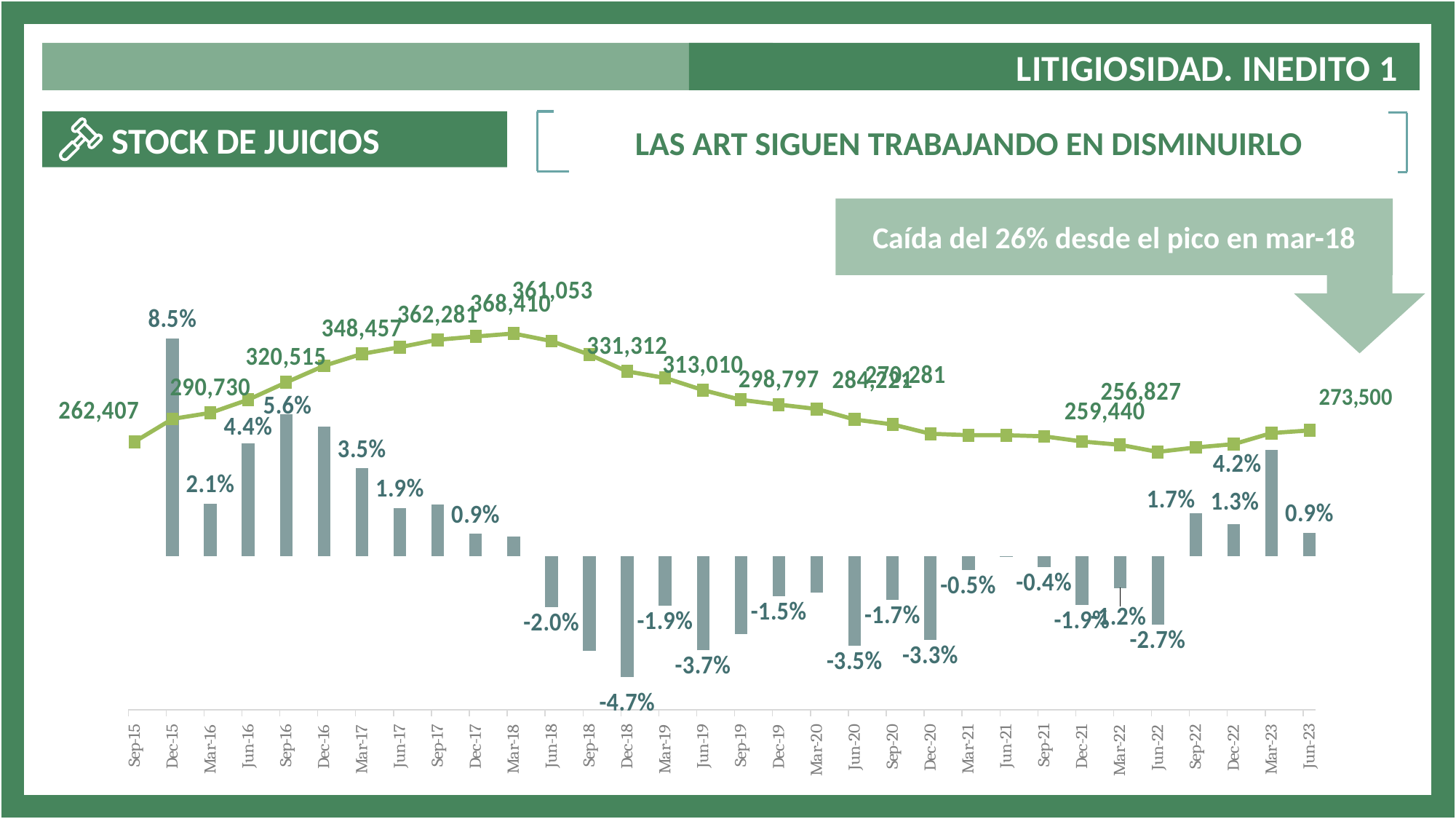
How many quarterly periods are shown on the x axis? 32 What is the percentage change shown by the bar at Dec-15? 8.5% What is the difference between the peak line value (368,410) and the Jun-23 value (273,500)? 94,910 Which period has the tallest positive bar (largest percentage increase)? Dec-15 What is the stock of lawsuits value labeled at Jun-23, the last point on the line? 273,500 Which period has the lowest bar (largest percentage decrease)? Dec-18 Which is larger, the line value at Sep-15 or the line value at Jun-23? Jun-23 What is the highest value labeled on the line, reached at the Mar-18 peak? 368,410 In which period does the line reach its peak? Mar-18 What is the percentage change shown by the bar at Dec-18? -4.7% What does the callout box above the chart say? Caída del 26% desde el pico en mar-18 What is the stock of lawsuits value labeled at Sep-15, the first point on the line? 262,407